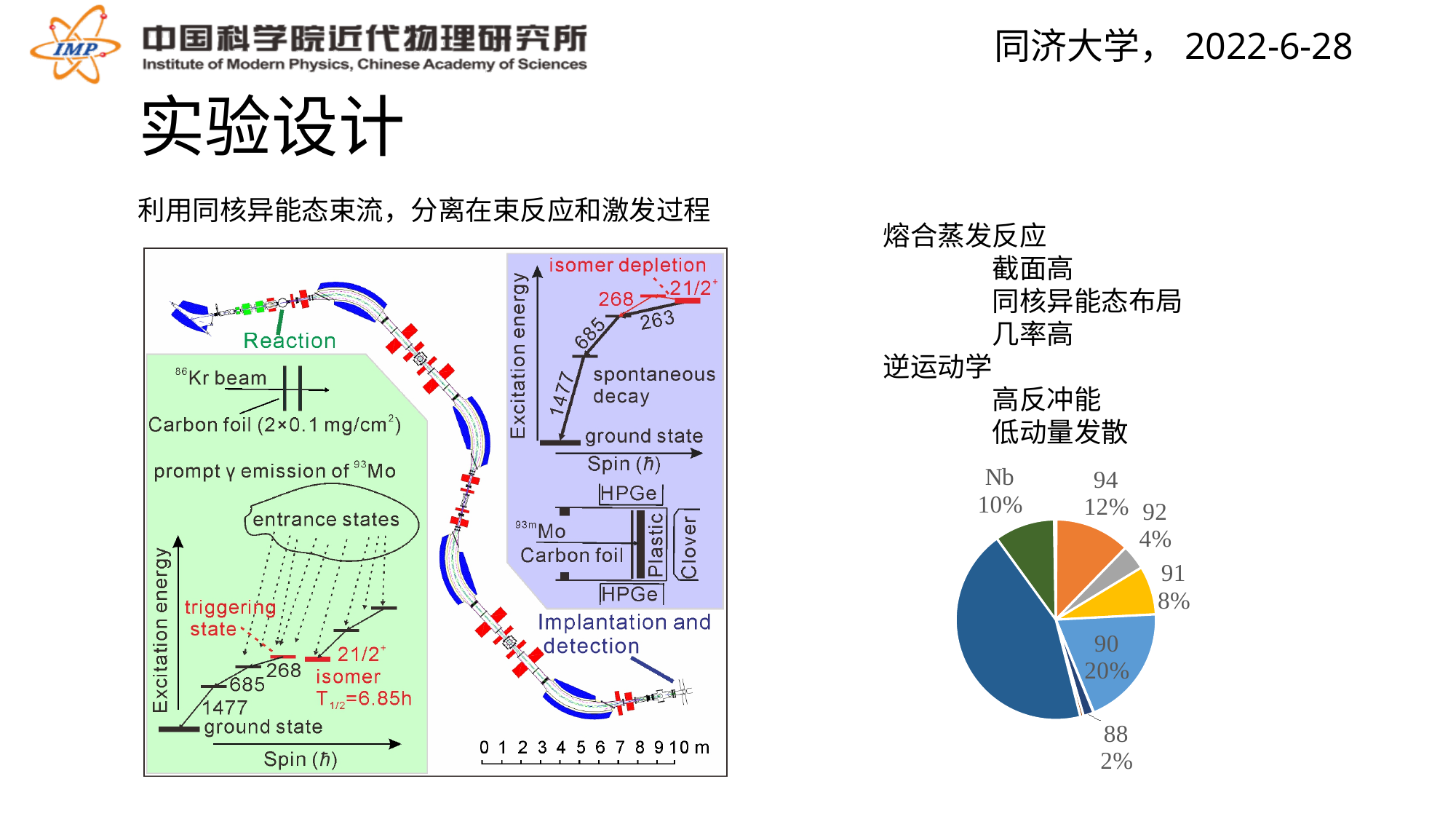
In the pie chart, what is the difference in percentage points between the shares of "94" and "92"? 8 In the pie chart, which labelled slice has the smallest share? 88 What kind of chart is shown on the right side of the slide? pie chart In the pie chart, what share is labelled for the slice "90"? 20% In the pie chart, what share is labelled for the slice "94"? 12% In the pie chart, what share is labelled for the slice "92"? 4% In the pie chart, what share is labelled for the slice "Nb"? 10% In the pie chart, what share is labelled for the slice "88"? 2% In the pie chart, what is the difference in percentage points between the shares of "90" and "88"? 18 In the pie chart, what share is labelled for the slice "91"? 8% In the pie chart, which slice is larger, "Nb" or "91"? Nb In the pie chart, which slice is larger, "90" or "94"? 90